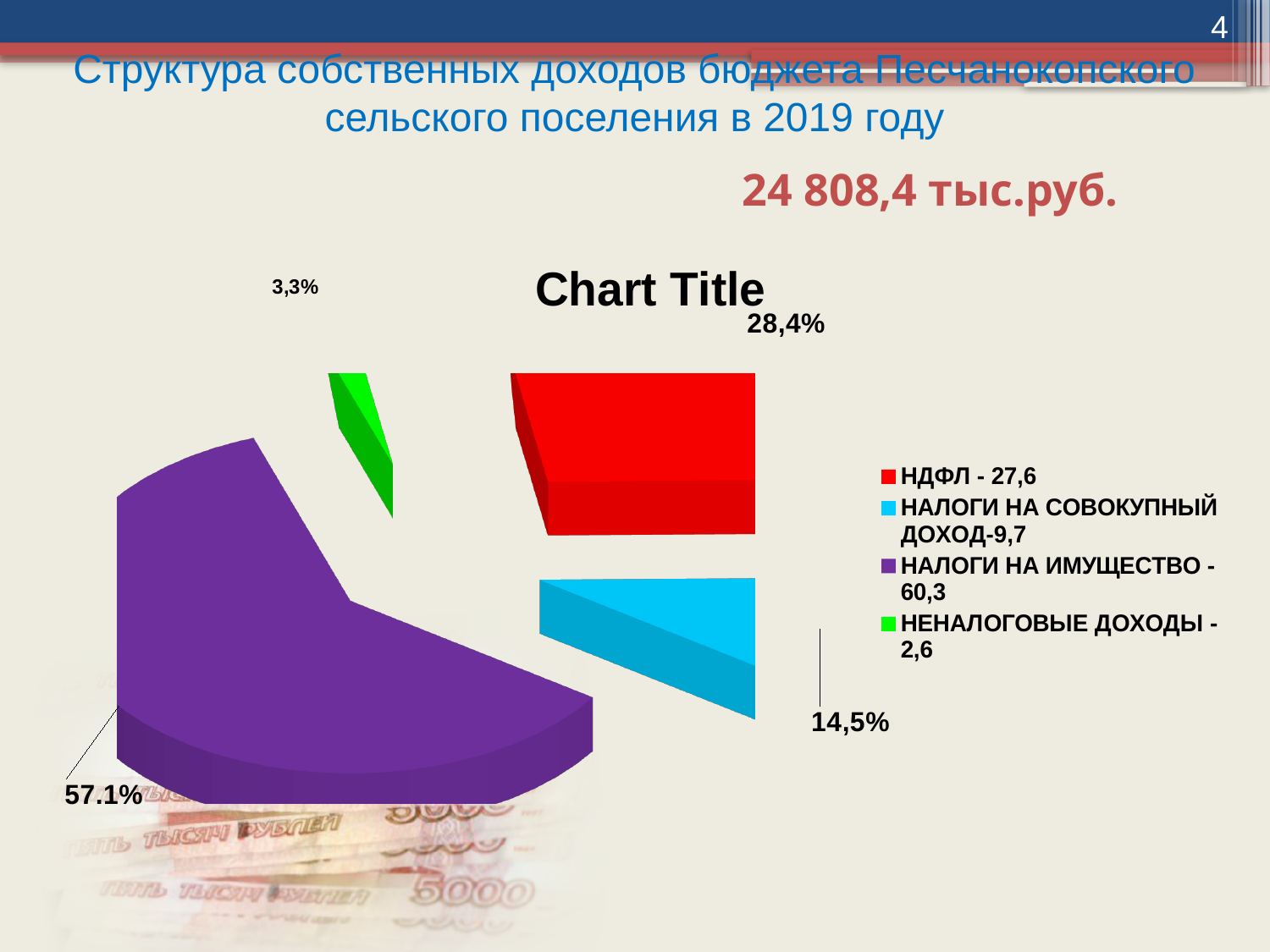
Which slice of the pie chart is the largest? НАЛОГИ НА ИМУЩЕСТВО How many entries does the legend of the pie chart list? 4 What value is given for НДФЛ in the legend of the pie chart? 27,6 What percentage label is shown on the red НДФЛ slice of the pie chart? 28,4% Which slice of the pie chart is larger, НДФЛ or НАЛОГИ НА СОВОКУПНЫЙ ДОХОД? НДФЛ How many slices does the pie chart have? 4 What percentage label is shown on the light blue НАЛОГИ НА СОВОКУПНЫЙ ДОХОД slice of the pie chart? 14,5% What percentage label is shown on the purple НАЛОГИ НА ИМУЩЕСТВО slice of the pie chart? 57.1% What is the title printed above the pie chart? Chart Title What kind of chart is shown on the slide? pie chart Which slice of the pie chart is the smallest? НЕНАЛОГОВЫЕ ДОХОДЫ What percentage label is shown on the green НЕНАЛОГОВЫЕ ДОХОДЫ slice of the pie chart? 3,3%